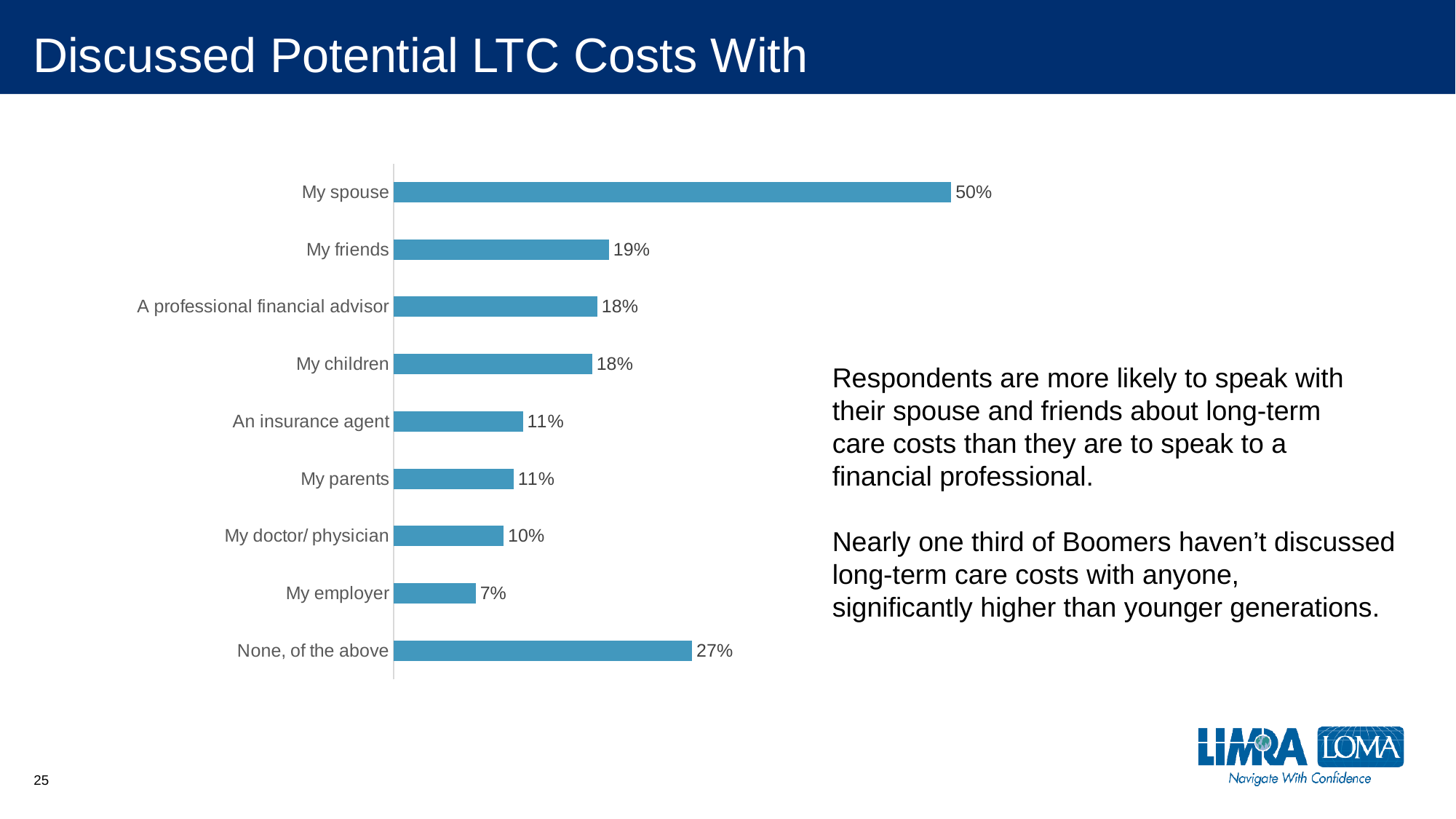
What is the difference between "None, of the above" and "My doctor/ physician"? 17% How many categories are shown in the chart? 9 What is the value for "A professional financial advisor"? 18% What percentage of respondents selected "None, of the above"? 27% What type of chart is shown on the slide? Bar chart Which category has the lowest value? My employer What is the difference between the values for "My spouse" and "My friends"? 31% What is the title of the slide containing the chart? Discussed Potential LTC Costs With What percentage of respondents discussed potential LTC costs with their spouse? 50% Which category has the highest value? My spouse What is the value for "My employer"? 7% Which is larger, the value for "My friends" or the value for "My parents"? My friends